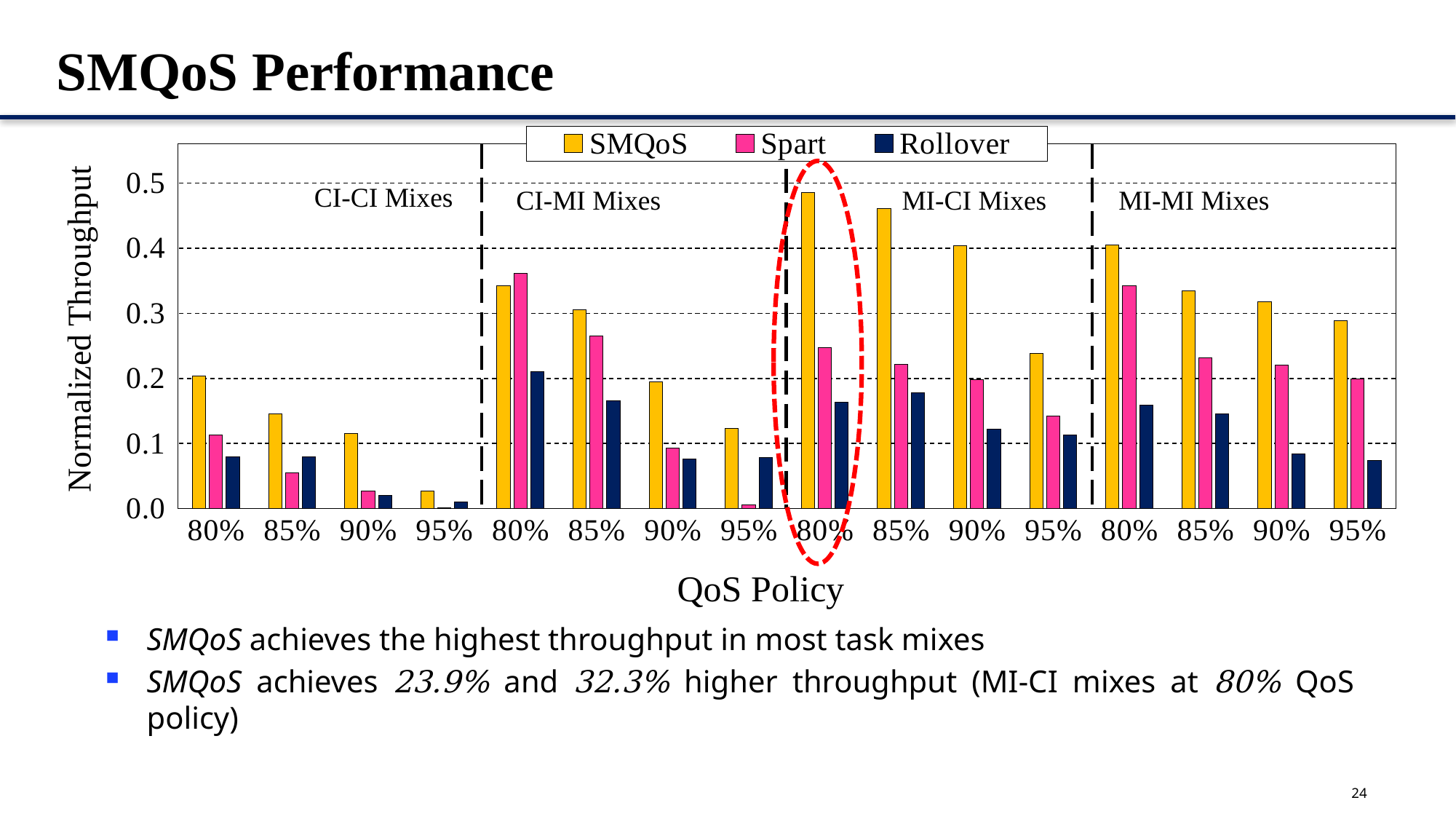
Is the Spart value for MI-CI Mixes at 80% greater or less than 0.3? less Is the SMQoS value for CI-CI Mixes at 85% greater or less than 0.1? greater In which mix and QoS policy does SMQoS reach its highest normalized throughput? MI-CI Mixes at 80% What kind of chart is shown on the slide? bar chart Within the MI-CI Mixes, does the SMQoS throughput rise or fall as the QoS policy goes from 80% to 95%? fall Is the Rollover value for MI-MI Mixes at 95% greater or less than 0.1? less What is the title of the x axis? QoS Policy How many QoS policy groups (x-axis categories) are plotted in total across all four mixes? 16 What colour represents the Rollover series in the legend? dark blue How many series does the legend list? 3 For MI-MI Mixes at 80%, which is larger, SMQoS or Rollover? SMQoS